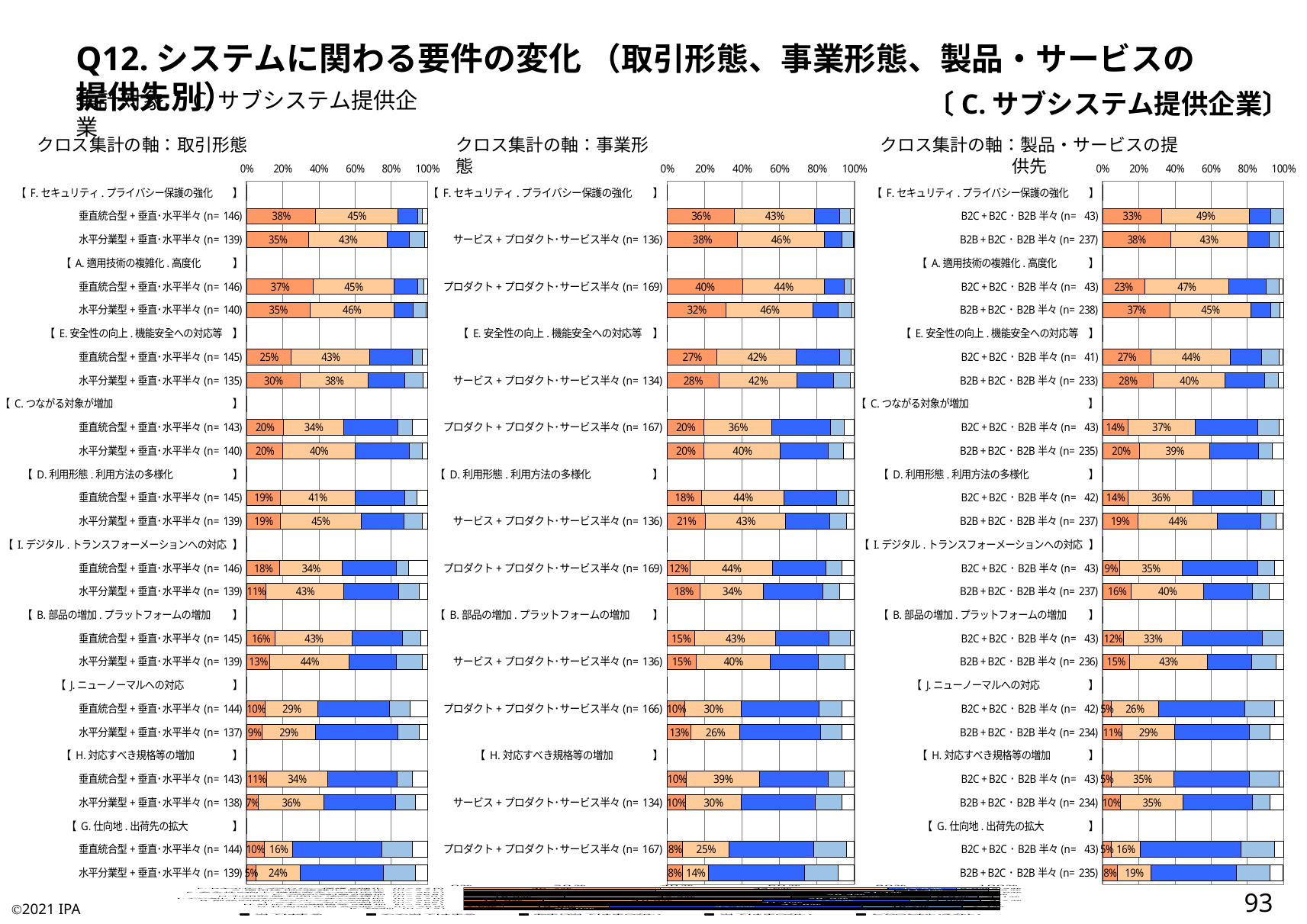
In the right chart (クロス集計の軸：製品・サービスの提供先), what is the value of the first (dark orange) segment for B2B＋B2C・B2B半々 (n=237) under I. デジタル.トランスフォーメーションへの対応? 16% In the middle chart (クロス集計の軸：事業形態), what is the value of the second (light orange) segment for サービス＋プロダクト･サービス半々 (n=134) under H. 対応すべき規格等の増加? 30% In the middle chart (クロス集計の軸：事業形態), what is the value of the first (dark orange) segment for プロダクト＋プロダクト･サービス半々 (n=169) under A. 適用技術の複雑化.高度化? 40% In the left chart (クロス集計の軸：取引形態), what is the combined value of the first two segments for 垂直統合型＋垂直･水平半々 (n=146) under F. セキュリティ.プライバシー保護の強化? 83% In the left chart (クロス集計の軸：取引形態), what is the value of the first (dark orange) segment for 垂直統合型＋垂直･水平半々 (n=146) under F. セキュリティ.プライバシー保護の強化? 38% What kind of chart is used on this slide for the three cross-tabulations? Stacked bar chart In the left chart (クロス集計の軸：取引形態), what is the difference between the first (dark orange) segment values of 垂直統合型＋垂直･水平半々 (n=146) and 水平分業型＋垂直･水平半々 (n=139) under I. デジタル.トランスフォーメーションへの対応? 7% In the right chart (クロス集計の軸：製品・サービスの提供先), which has the larger first (dark orange) segment under A. 適用技術の複雑化.高度化: B2C＋B2C・B2B半々 (n=43) or B2B＋B2C・B2B半々 (n=238)? B2B＋B2C・B2B半々 (n=238) In the middle chart (クロス集計の軸：事業形態), which has the larger second (light orange) segment under G. 仕向地.出荷先の拡大: プロダクト＋プロダクト･サービス半々 (n=167) or サービス＋プロダクト･サービス半々? プロダクト＋プロダクト･サービス半々 (n=167) In the right chart (クロス集計の軸：製品・サービスの提供先), what is the value of the second (light orange) segment for B2C＋B2C・B2B半々 (n=43) under F. セキュリティ.プライバシー保護の強化? 49% How many separate charts are shown on this slide? 3 In the left chart (クロス集計の軸：取引形態), what is the value of the second (light orange) segment for 水平分業型＋垂直･水平半々 (n=140) under A. 適用技術の複雑化.高度化? 46%